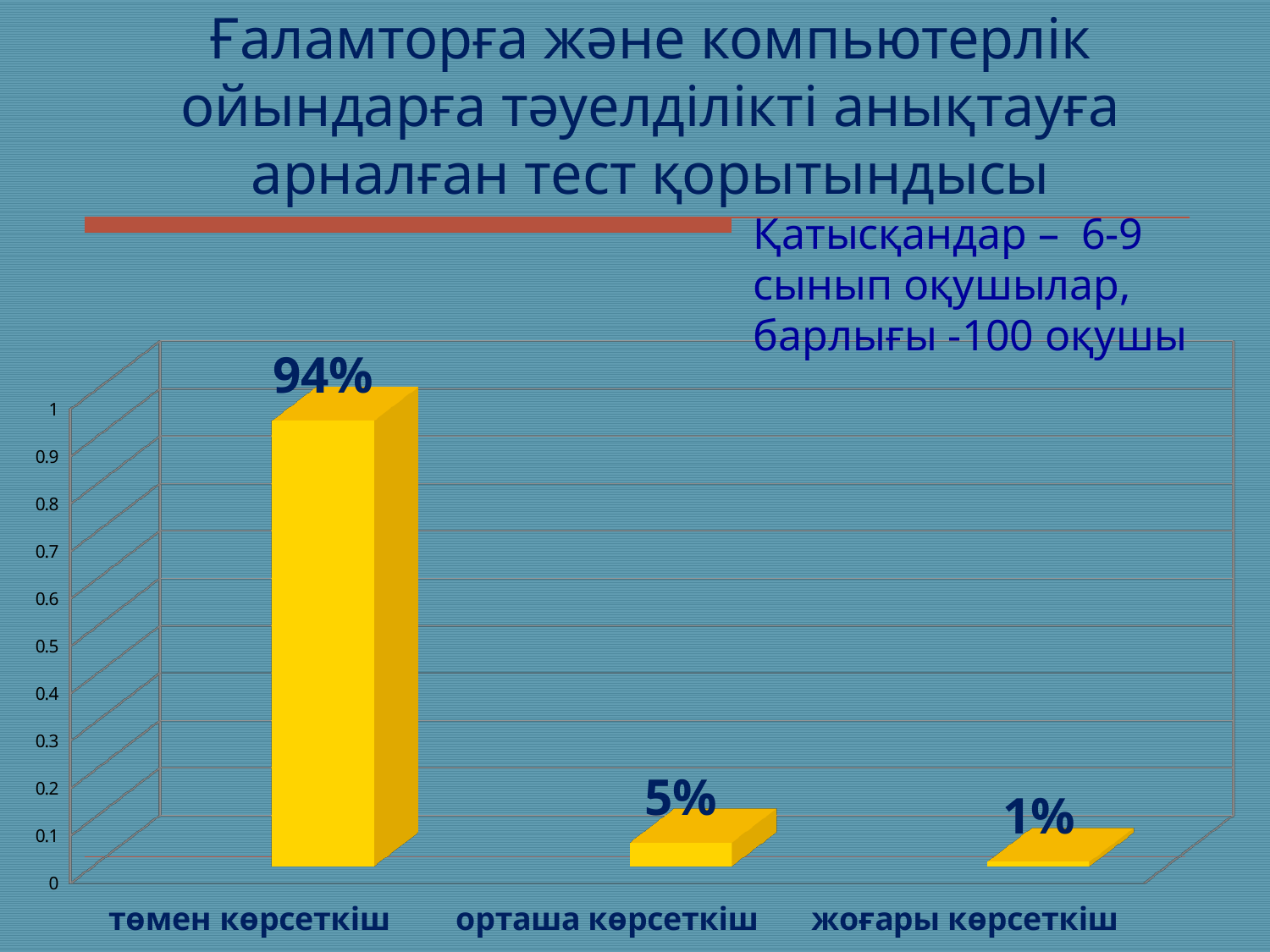
Is the value for төмен көрсеткіш greater or less than 0.5 on the axis? greater What is the value for орташа көрсеткіш? 5% Which category has the highest value? төмен көрсеткіш Which is larger, the value for орташа көрсеткіш or the value for жоғары көрсеткіш? орташа көрсеткіш What is the difference between the values for орташа көрсеткіш and жоғары көрсеткіш? 4% Which category has the lowest value? жоғары көрсеткіш Do the values rise or fall from left to right along the x axis? fall How many categories are shown on the x axis? 3 What is the value for жоғары көрсеткіш? 1% What kind of chart is shown on the slide? bar chart What is the difference between the values for төмен көрсеткіш and орташа көрсеткіш? 89% What is the value for төмен көрсеткіш? 94%